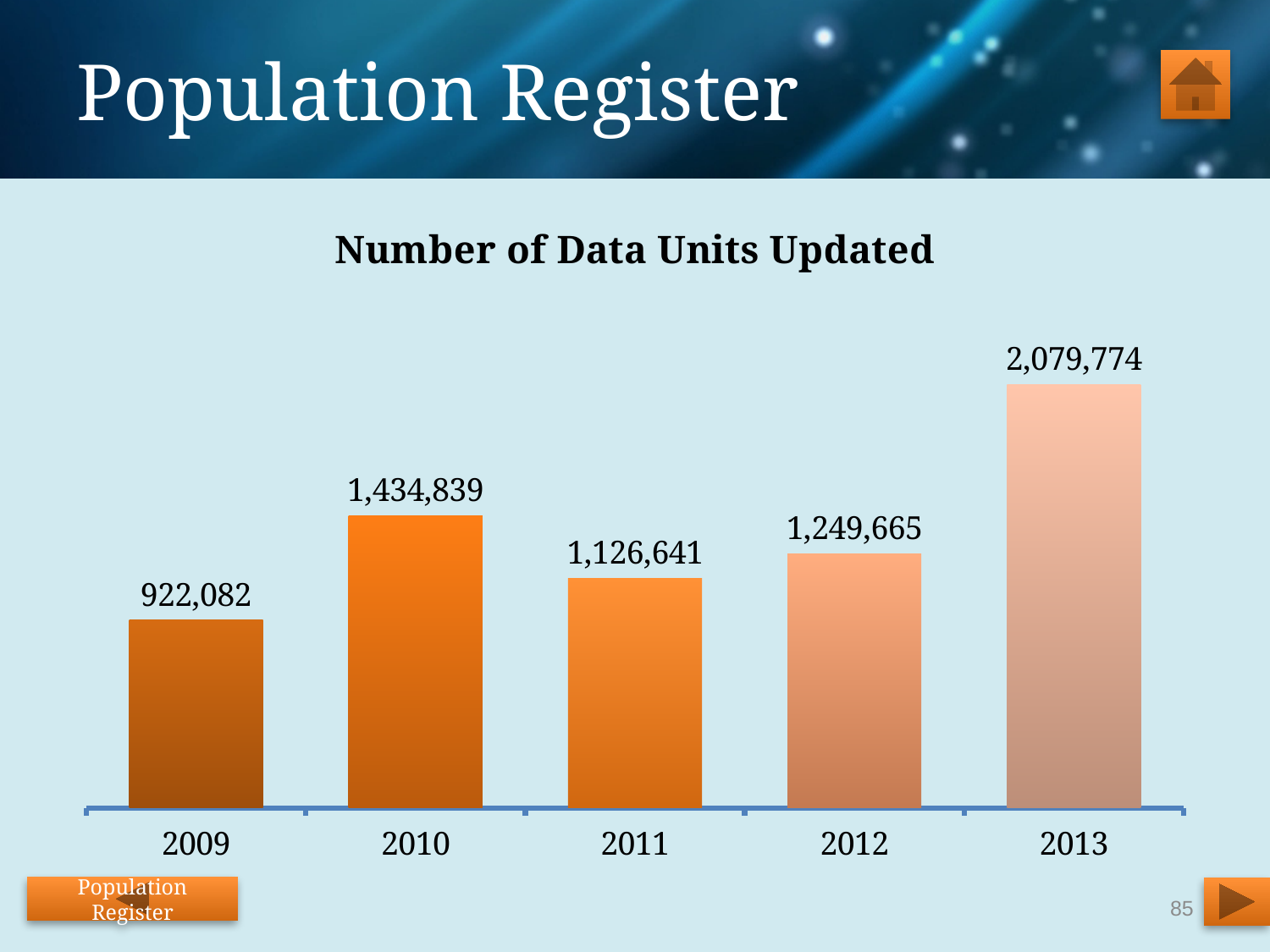
What kind of chart is shown on the slide? Bar chart Which year has the highest number of data units updated? 2013 Which year has the larger value, 2010 or 2012? 2010 What is the value for 2009 in the Number of Data Units Updated chart? 922,082 What is the value for 2011 in the Number of Data Units Updated chart? 1,126,641 What is the difference between the values for 2013 and 2009? 1,157,692 Does the number of data units updated rise or fall from 2010 to 2011? Fall Which year has the lowest number of data units updated? 2009 What is the value for 2013 in the Number of Data Units Updated chart? 2,079,774 What is the title of the chart on the slide? Number of Data Units Updated What is the difference between the values for 2010 and 2011? 308,198 How many years are shown on the x axis of the chart? 5